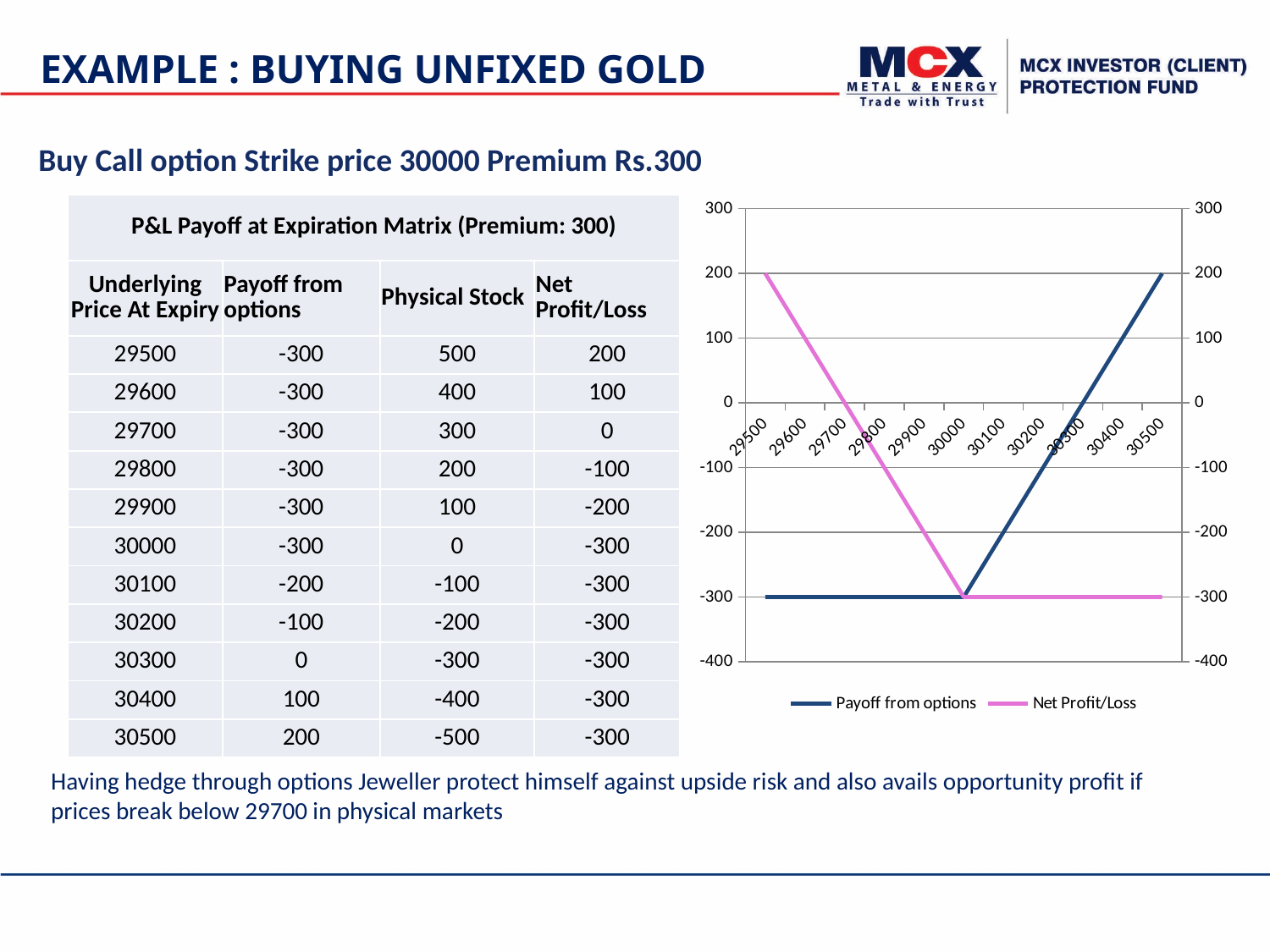
What is the difference between Net Profit/Loss and Payoff from options at an underlying price of 29500? 500 What kind of chart is shown on the slide? Line chart How many series does the chart legend list? 2 Which colour is used for the Net Profit/Loss line in the chart? Pink What is the Net Profit/Loss value at an underlying price of 29500? 200 What is the Net Profit/Loss value at an underlying price of 30000? -300 At an underlying price of 29600, which series has the larger value, Payoff from options or Net Profit/Loss? Net Profit/Loss What is the value of Payoff from options at an underlying price of 30500? 200 What is the value of Payoff from options at an underlying price of 29500? -300 Does the Payoff from options line rise or fall as the underlying price increases from 30000 to 30500? Rise How many underlying price points are plotted along the x axis of the chart? 11 At which underlying price is Net Profit/Loss highest? 29500